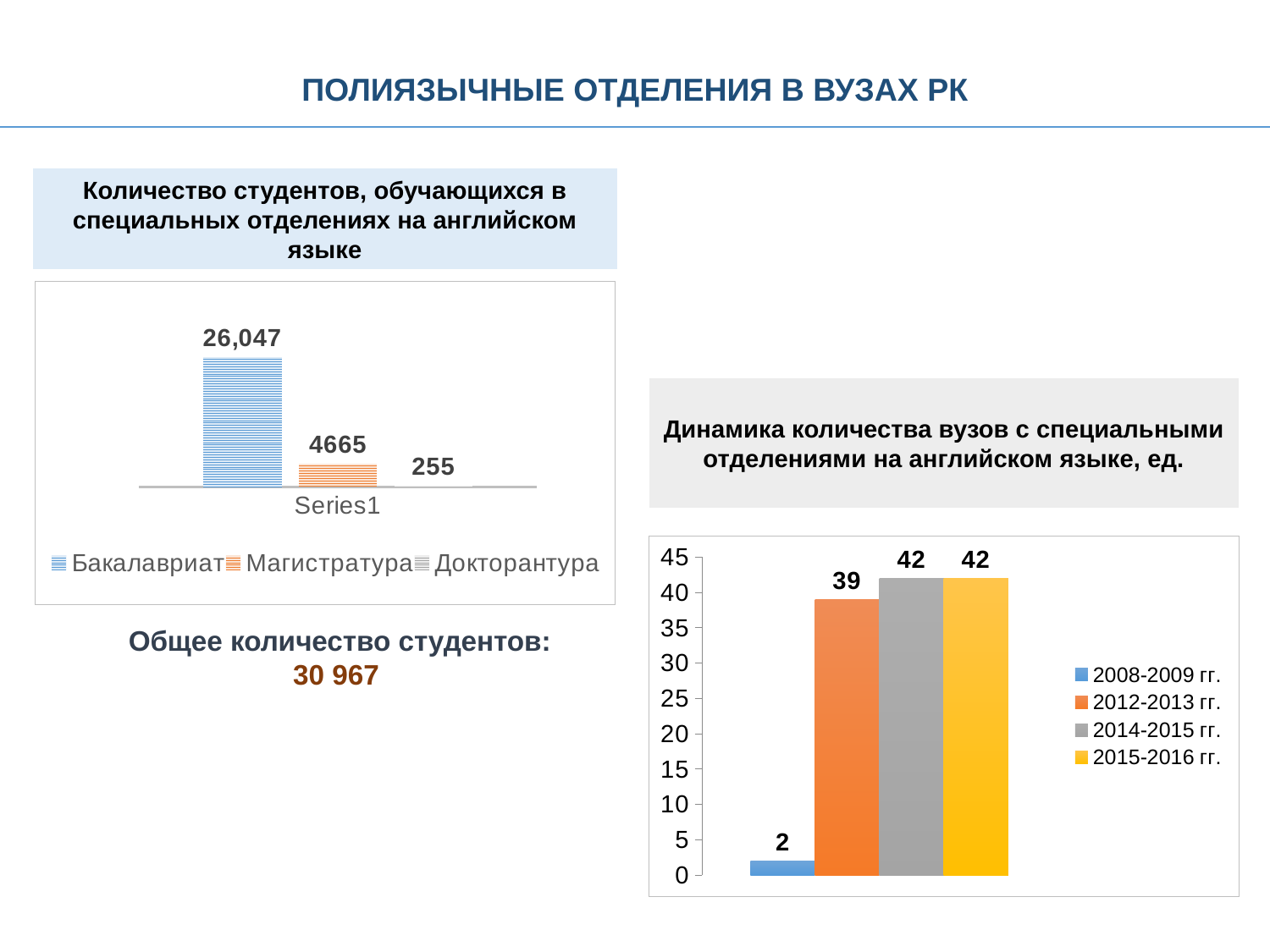
In the left chart, what is the difference between the values for Магистратура and Докторантура? 4410 In the left chart (Количество студентов, обучающихся в специальных отделениях на английском языке), what is the value for Бакалавриат? 26,047 In the right chart, what is the difference between the values for 2014-2015 гг. and 2012-2013 гг.? 3 In the right chart (Динамика количества вузов с специальными отделениями на английском языке, ед.), what is the value for 2012-2013 гг.? 39 What kind of chart is the right chart? bar chart In the right chart, what is the value for 2015-2016 гг.? 42 In the left chart, how many series does the legend list? 3 In the left chart, what is the value for Магистратура? 4665 In the right chart, what is the value for 2008-2009 гг.? 2 In the left chart, which series has the lowest value? Докторантура In the left chart, what is the value for Докторантура? 255 In the right chart, which series has the lowest value? 2008-2009 гг.